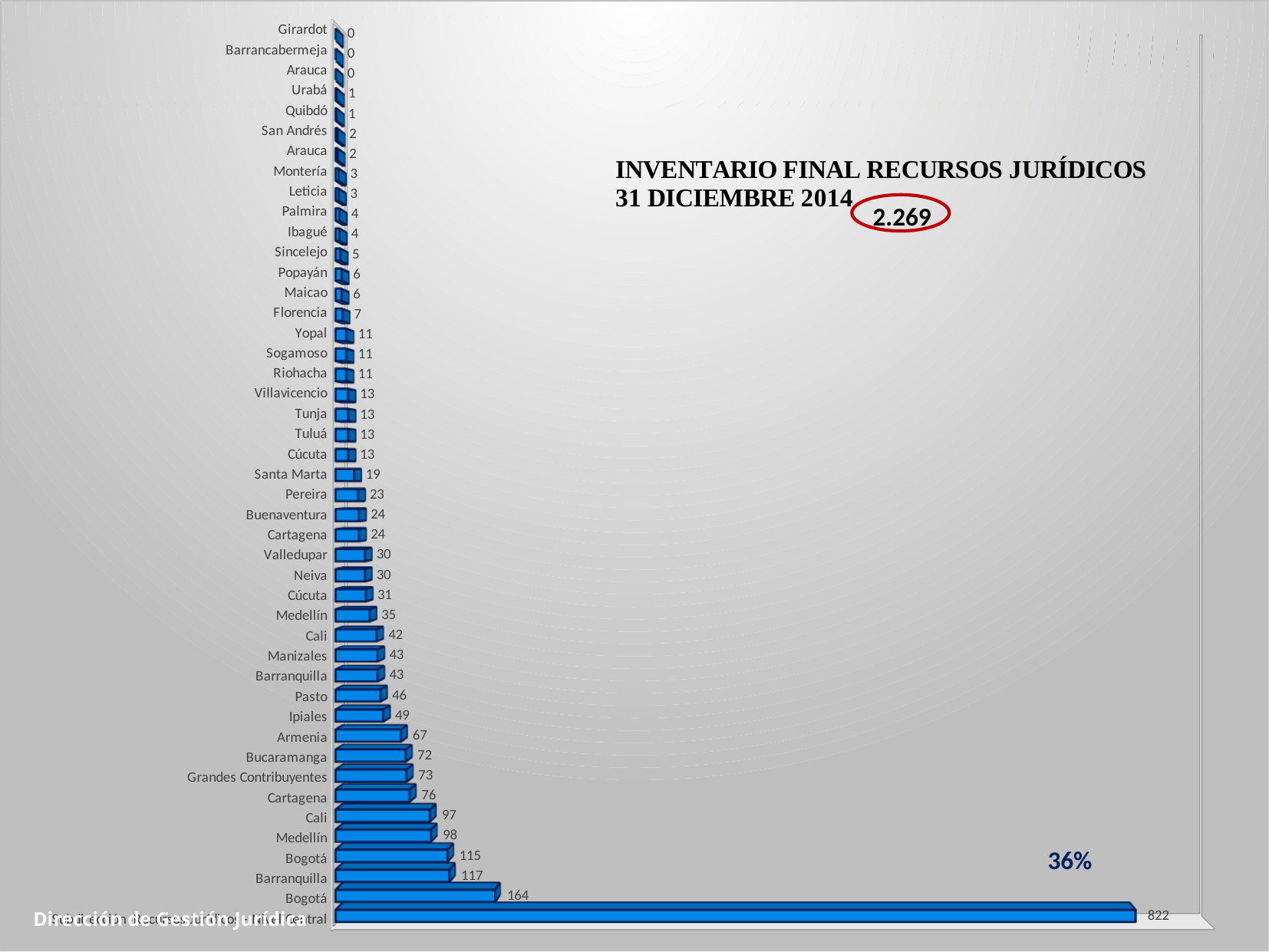
What is the value for Armenia? 67 What total figure is circled in red next to the chart title? 2.269 What is the value for Florencia? 7 What is the difference between the values for Pereira and Santa Marta? 4 What is the value for Ipiales? 49 Which has a larger value, Villavicencio or Yopal? Villavicencio What is the difference between the values for Bucaramanga and Armenia? 5 What is the value for Santa Marta? 19 Which has a larger value, Pasto or Manizales? Pasto What is the value of the longest bar in the chart? 822 What is the value for Grandes Contribuyentes? 73 What kind of chart is shown on the slide? bar chart